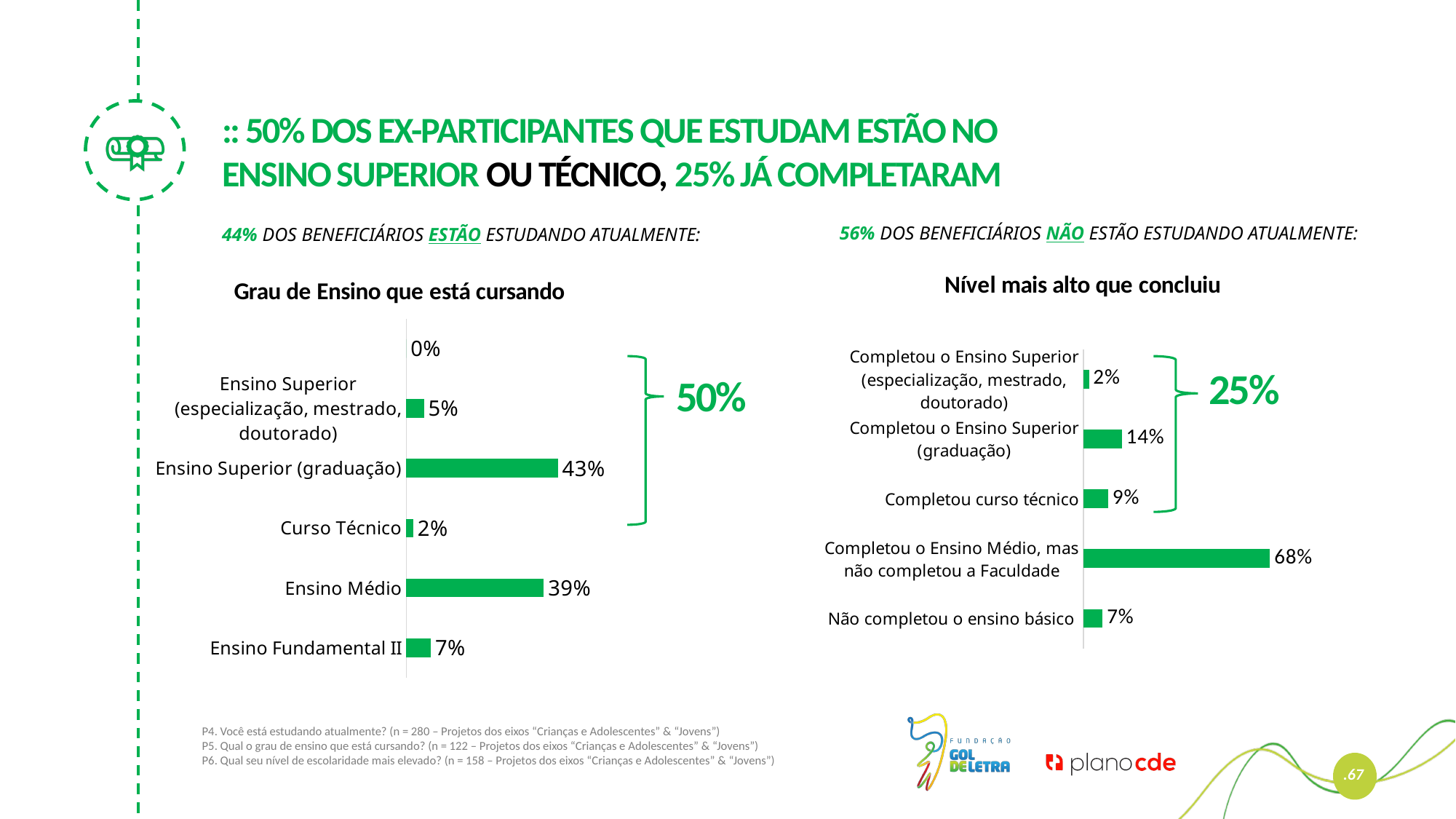
In the chart 'Nível mais alto que concluiu', how many categories are shown? 5 In the chart 'Grau de Ensino que está cursando', which category has the highest value? Ensino Superior (graduação) In the chart 'Grau de Ensino que está cursando', what is the difference between Ensino Superior (graduação) and Ensino Médio? 4 percentage points What type of chart is 'Nível mais alto que concluiu'? Bar chart In the chart 'Nível mais alto que concluiu', what is the difference between 'Completou o Ensino Superior (graduação)' and 'Não completou o ensino básico'? 7 percentage points What percentage is shown next to the bracket on the chart 'Nível mais alto que concluiu'? 25% In the chart 'Grau de Ensino que está cursando', which is larger: Ensino Fundamental II or Curso Técnico? Ensino Fundamental II In the chart 'Grau de Ensino que está cursando', what is the value for Ensino Médio? 39% In the chart 'Nível mais alto que concluiu', what is the value for 'Completou curso técnico'? 9% In the chart 'Nível mais alto que concluiu', what is the value for 'Completou o Ensino Médio, mas não completou a Faculdade'? 68% In the chart 'Grau de Ensino que está cursando', what is the value for Ensino Superior (graduação)? 43% In the chart 'Nível mais alto que concluiu', which category has the lowest value? Completou o Ensino Superior (especialização, mestrado, doutorado)